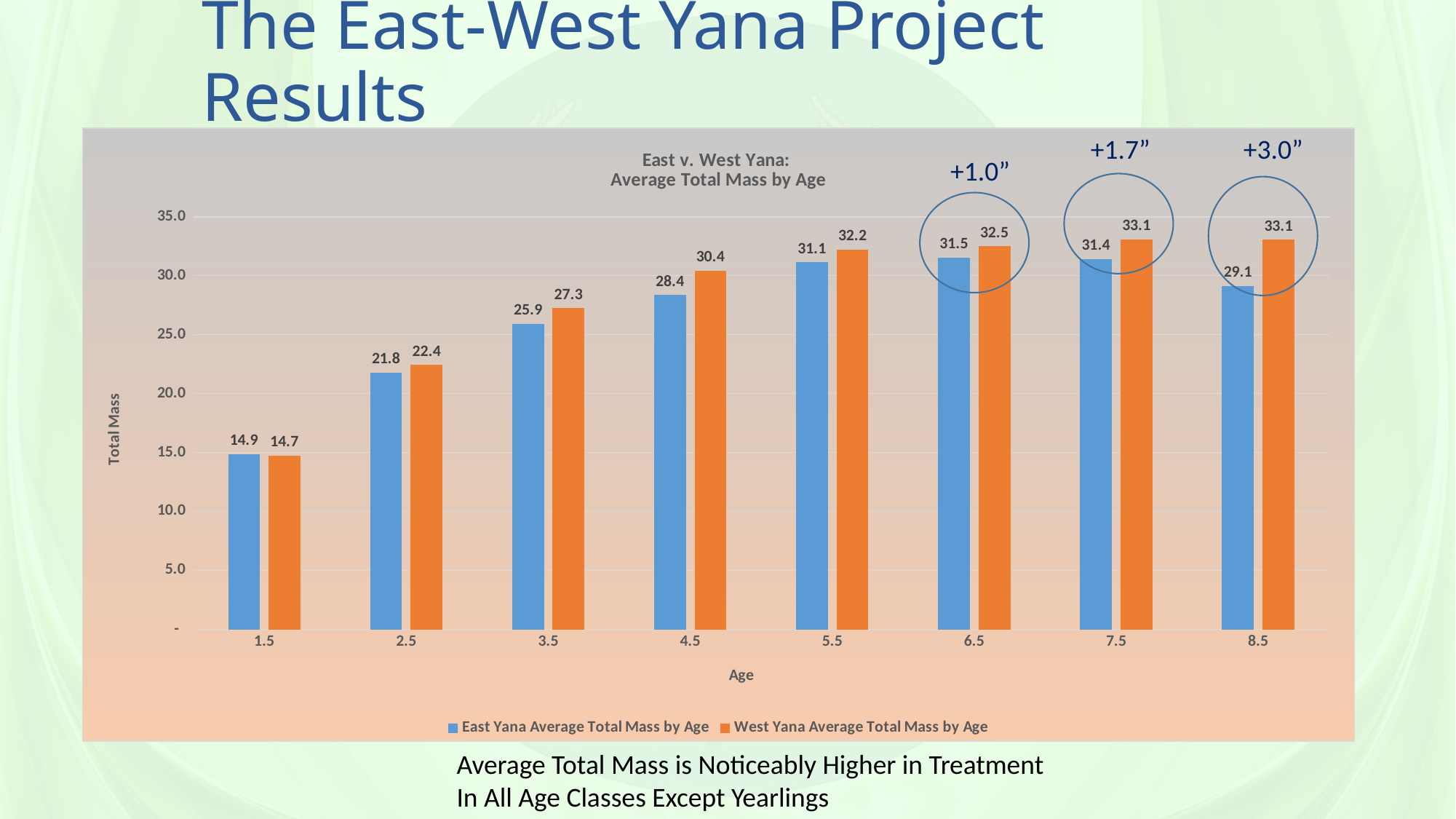
At age 1.5, which is larger: the East Yana or the West Yana average total mass? East Yana What kind of chart is shown on the slide? Bar chart At which age is the East Yana average total mass lowest? 1.5 What is the difference between the West Yana and East Yana average total mass at age 8.5? 4.0 What is the difference between the West Yana and East Yana average total mass at age 4.5? 2.0 How many series does the legend list? 2 At which age is the East Yana average total mass highest? 6.5 What is the West Yana average total mass at age 8.5? 33.1 How many age classes are shown on the x axis? 8 What is the West Yana average total mass at age 3.5? 27.3 What is the East Yana average total mass at age 4.5? 28.4 What is the East Yana average total mass at age 2.5? 21.8